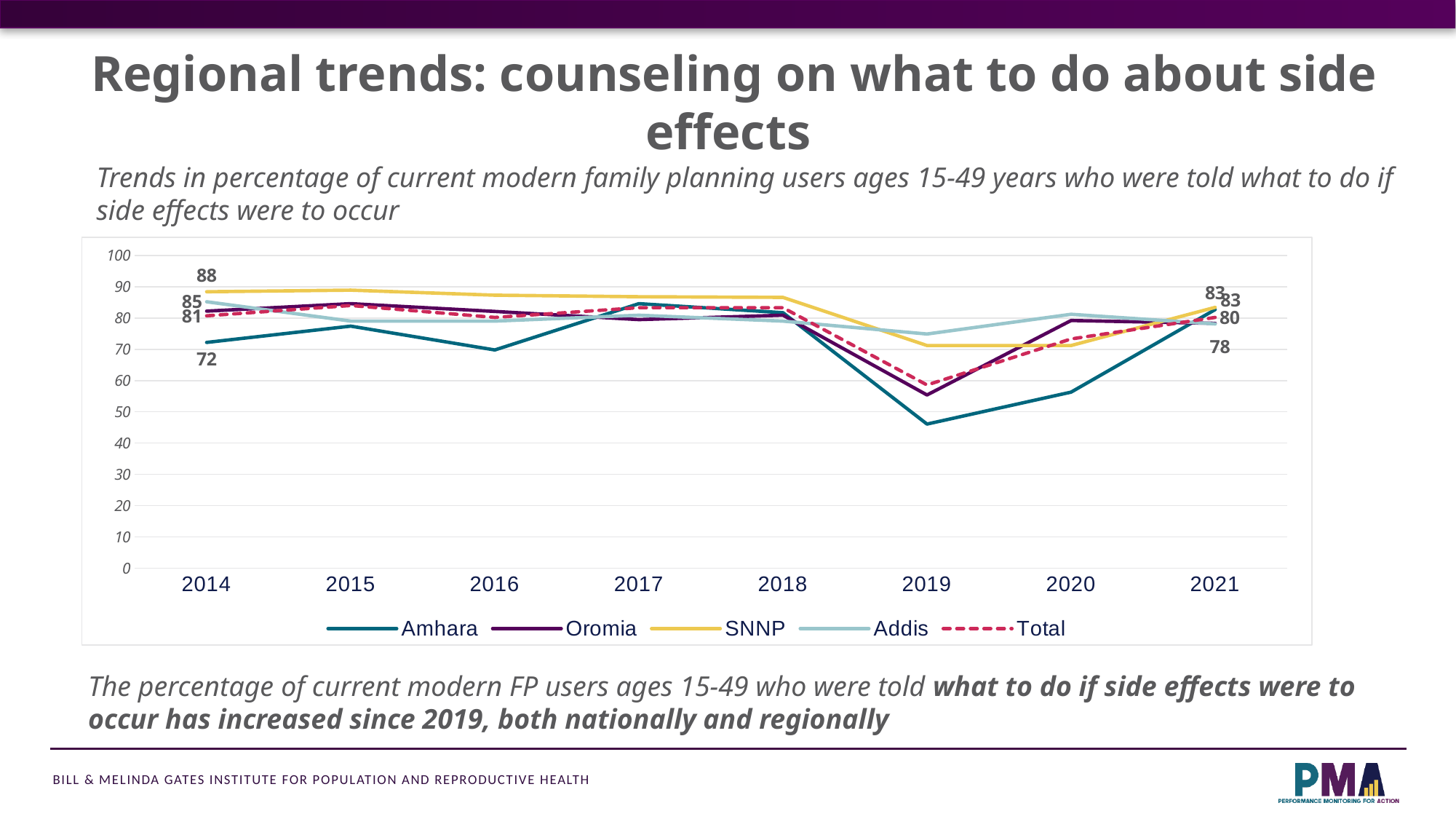
Which series has the lowest value in 2019? Amhara Which region has the highest value in 2014? SNNP What kind of chart is shown on the slide? line chart What is the difference between the SNNP and Amhara values in 2014? 16 How many years are shown on the x axis? 8 What is the value for Addis in 2014? 85 Does the Amhara line rise or fall from 2019 to 2021? rise What is the value for SNNP in 2014? 88 What is the value for Amhara in 2014? 72 Which series is drawn with a dashed line? Total How many series does the legend list? 5 Is the value for Amhara in 2019 greater or less than 50? less